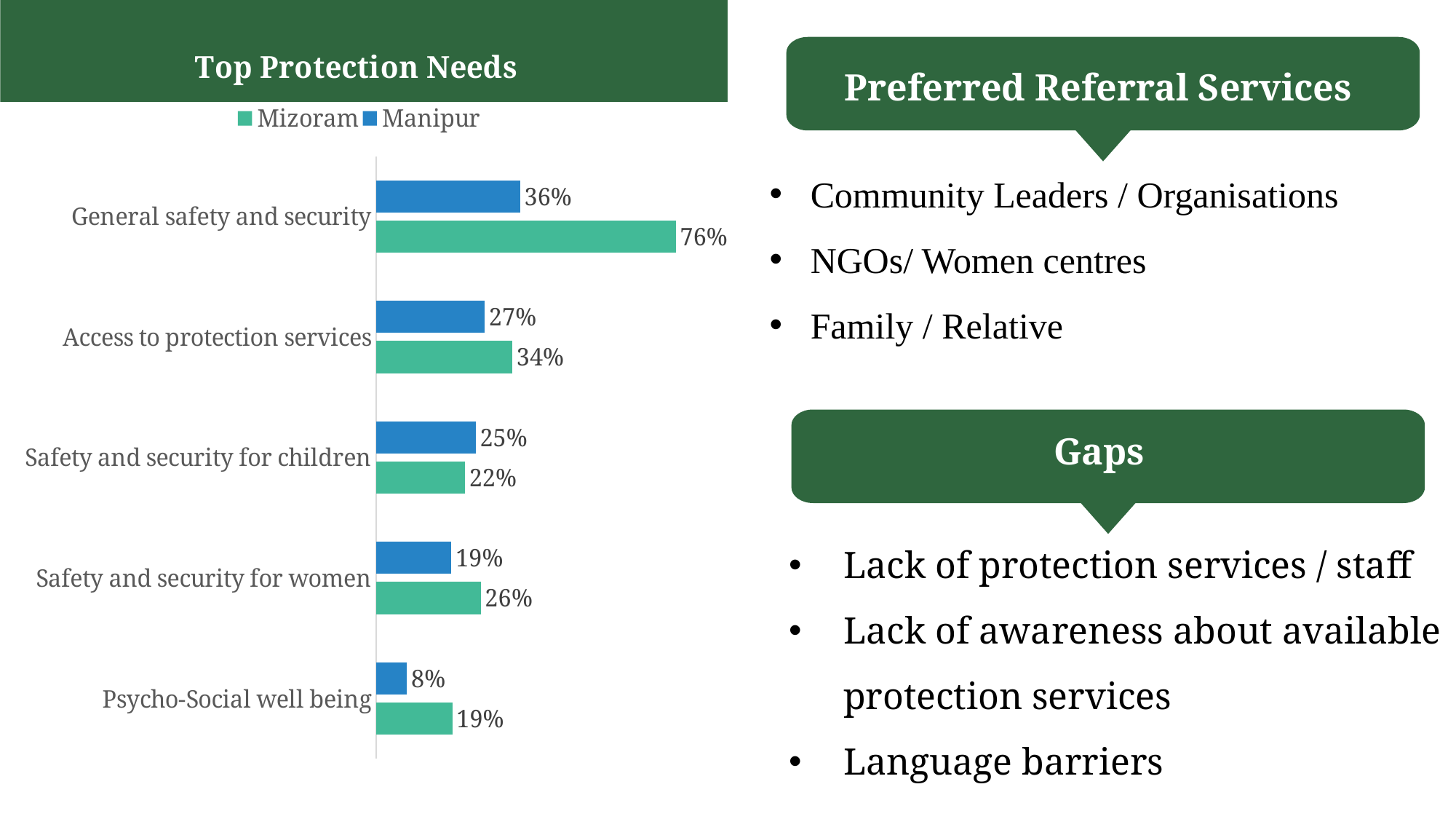
What is the difference between the Mizoram and Manipur values for General safety and security? 40% For Safety and security for children, which is larger: the Mizoram value or the Manipur value? Manipur What kind of chart is the Top Protection Needs chart? Bar chart What is the title of the chart on the slide? Top Protection Needs How many series does the legend of the Top Protection Needs chart list? 2 What is the Mizoram value for General safety and security? 76% What is the Manipur value for Access to protection services? 27% How many categories are shown in the Top Protection Needs chart? 5 Which category has the highest Mizoram value? General safety and security What is the difference between the Mizoram and Manipur values for Safety and security for women? 7% Which category has the lowest Manipur value? Psycho-Social well being What is the Manipur value for Psycho-Social well being? 8%